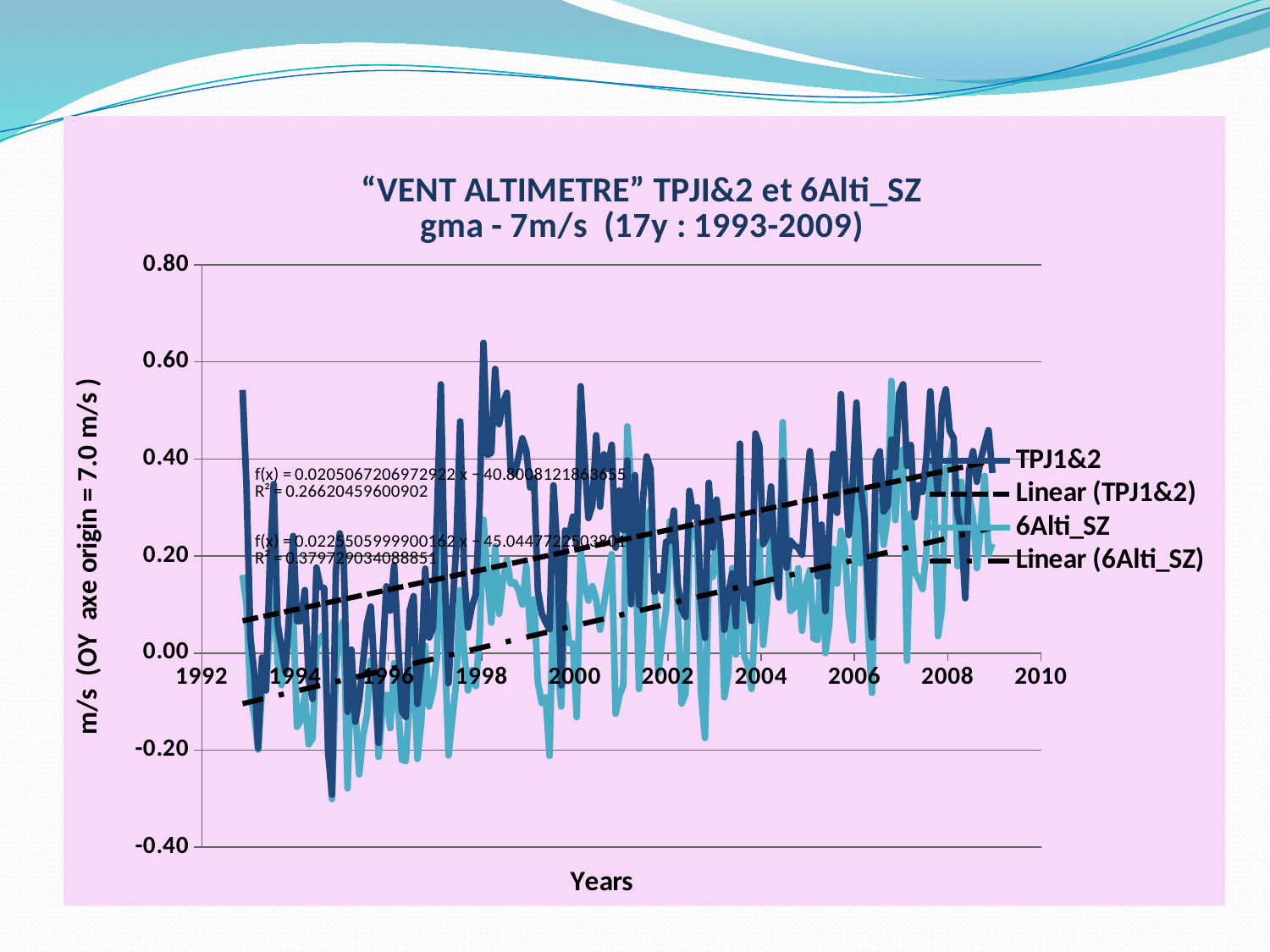
Does the linear trend line for 6Alti_SZ rise or fall across the years shown? rise What is the label of the x axis? Years What R² value is printed for the 6Alti_SZ linear fit? 0.379729034088851 What kind of chart is shown on the slide? line chart How many entries does the chart legend list? 4 Is the highest peak of the TPJ1&2 series (around 1998) greater or less than 0.60? greater What R² value is printed for the TPJ1&2 linear fit? 0.26620459600902 Which linear fit has the larger slope, TPJ1&2 (0.0205067206972922) or 6Alti_SZ (0.0225505999900162)? 6Alti_SZ Does the linear trend line for TPJ1&2 rise or fall from 1993 to 2009? rise What is the title of the chart? "VENT ALTIMETRE" TPJI&2 et 6Alti_SZ gma - 7m/s (17y : 1993-2009) Is the lowest point of the 6Alti_SZ series (around 1995) greater or less than -0.20? less Which linear fit has the higher R² value, TPJ1&2 or 6Alti_SZ? 6Alti_SZ